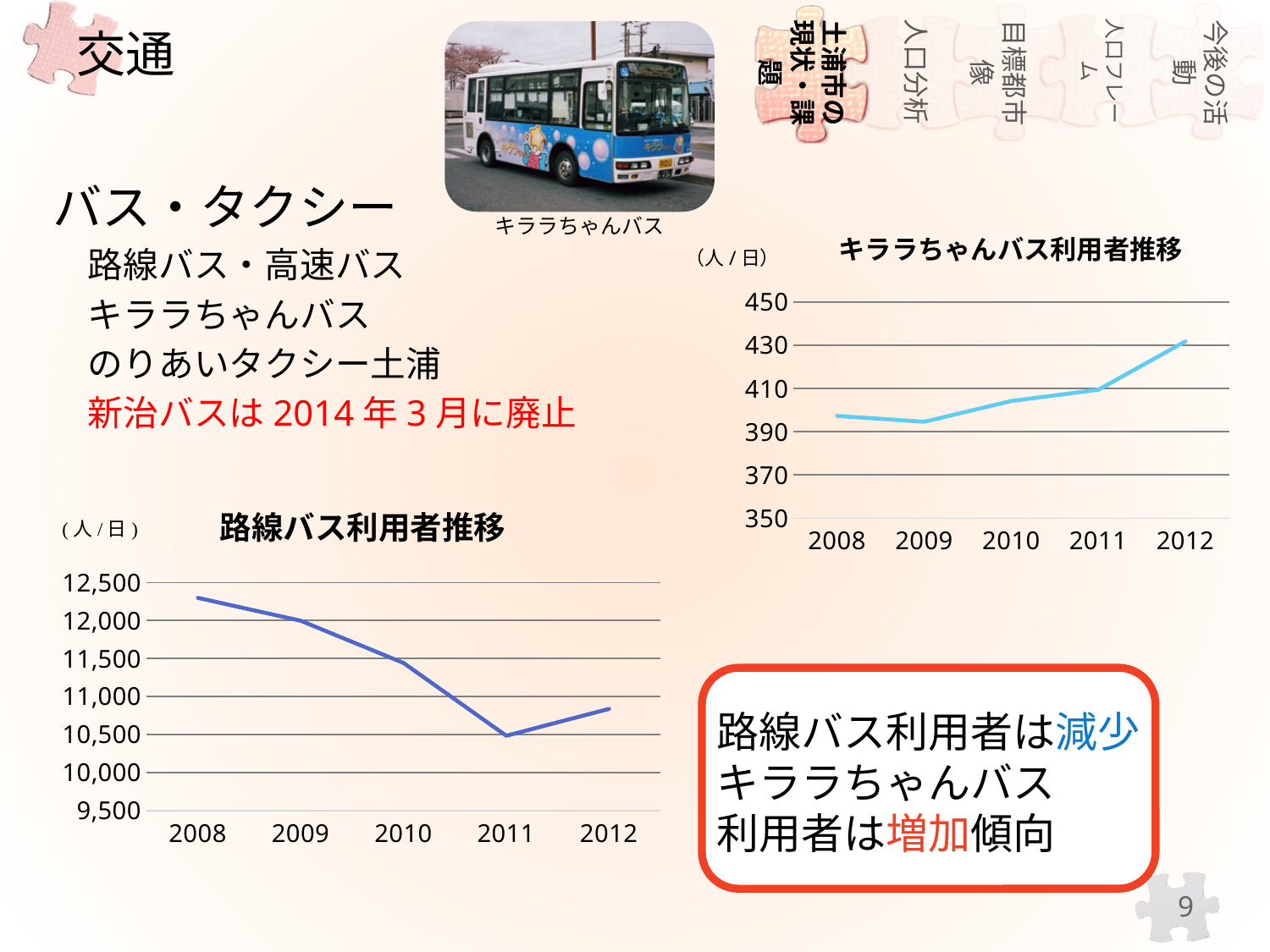
What kind of chart is the 路線バス利用者推移 chart? line chart How many years are plotted on the x axis of the キララちゃんバス利用者推移 chart? 5 In the キララちゃんバス利用者推移 chart, is the value for 2008 greater or less than 410? less In the キララちゃんバス利用者推移 chart, which year has the highest value? 2012 How many years are plotted on the x axis of the 路線バス利用者推移 chart? 5 In the キララちゃんバス利用者推移 chart, is the value for 2012 greater or less than 410? greater What kind of chart is the キララちゃんバス利用者推移 chart? line chart In the 路線バス利用者推移 chart, is the value for 2008 greater or less than 12,000? greater In the キララちゃんバス利用者推移 chart, do the values generally rise or fall from 2008 to 2012? rise In the 路線バス利用者推移 chart, which year has the lowest value? 2011 In the 路線バス利用者推移 chart, which year has the highest value? 2008